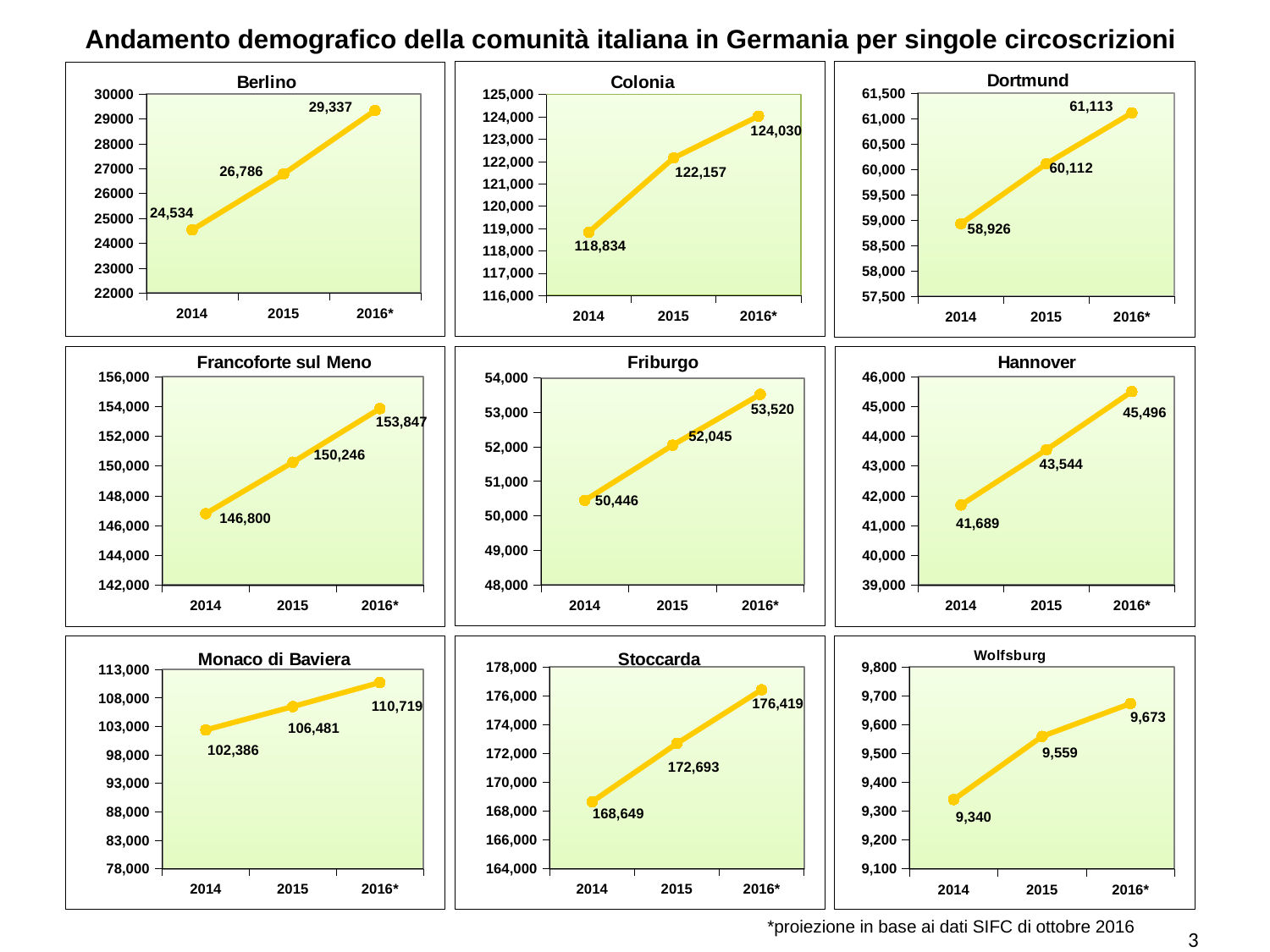
In the Wolfsburg chart, do the values rise or fall from 2014 to 2016*? rise In the Friburgo chart, which year has the lowest value? 2014 In the Wolfsburg chart, is the value for 2015 larger or smaller than the value for 2016*? smaller In the Hannover chart, what is the difference between the 2016* value and the 2014 value? 3,807 In the Francoforte sul Meno chart, which year has the highest value? 2016* How many data points are plotted in the Berlino chart? 3 In the Monaco di Baviera chart, is the value for 2014 greater or less than 98,000? greater In the Colonia chart, what is the value for 2014? 118,834 In the Stoccarda chart, what is the difference between the 2016* value and the 2015 value? 3,726 In the Dortmund chart, what is the value for 2015? 60,112 In the Berlino chart, what is the value for 2016*? 29,337 What kind of chart is the Stoccarda chart? line chart